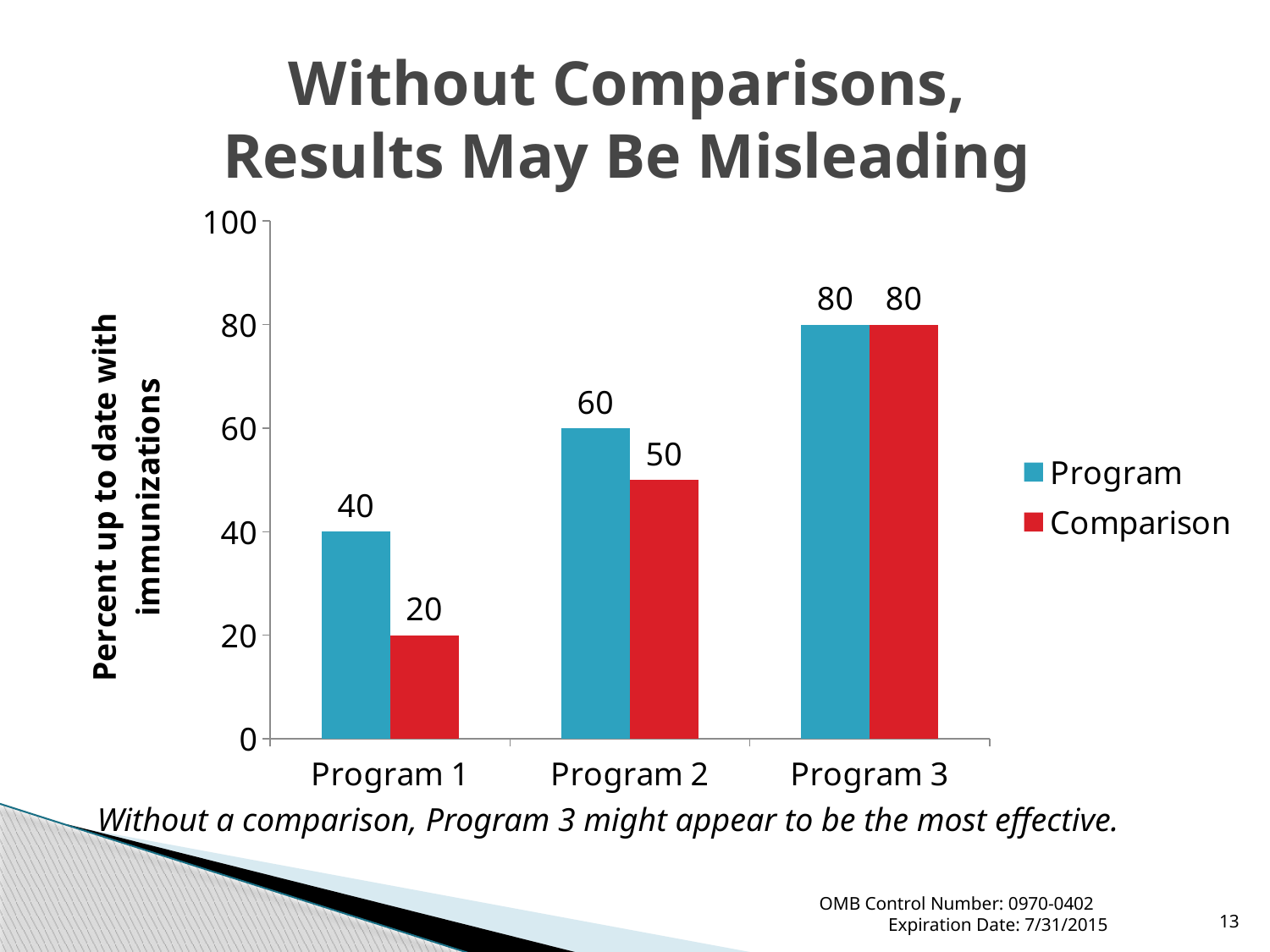
What is the difference between the Program and Comparison values for Program 1? 20 Which category has the highest Program value? Program 3 How many categories are shown on the x axis? 3 What kind of chart is shown on the slide? Bar chart Which category has the lowest Comparison value? Program 1 How many series does the legend list? 2 What is the Comparison value for Program 2? 50 Which is larger for Program 2, the Program value or the Comparison value? Program What is the Program value for Program 1? 40 What is the label of the vertical axis? Percent up to date with immunizations What is the Comparison value for Program 3? 80 What is the difference between the Program values for Program 2 and Program 1? 20